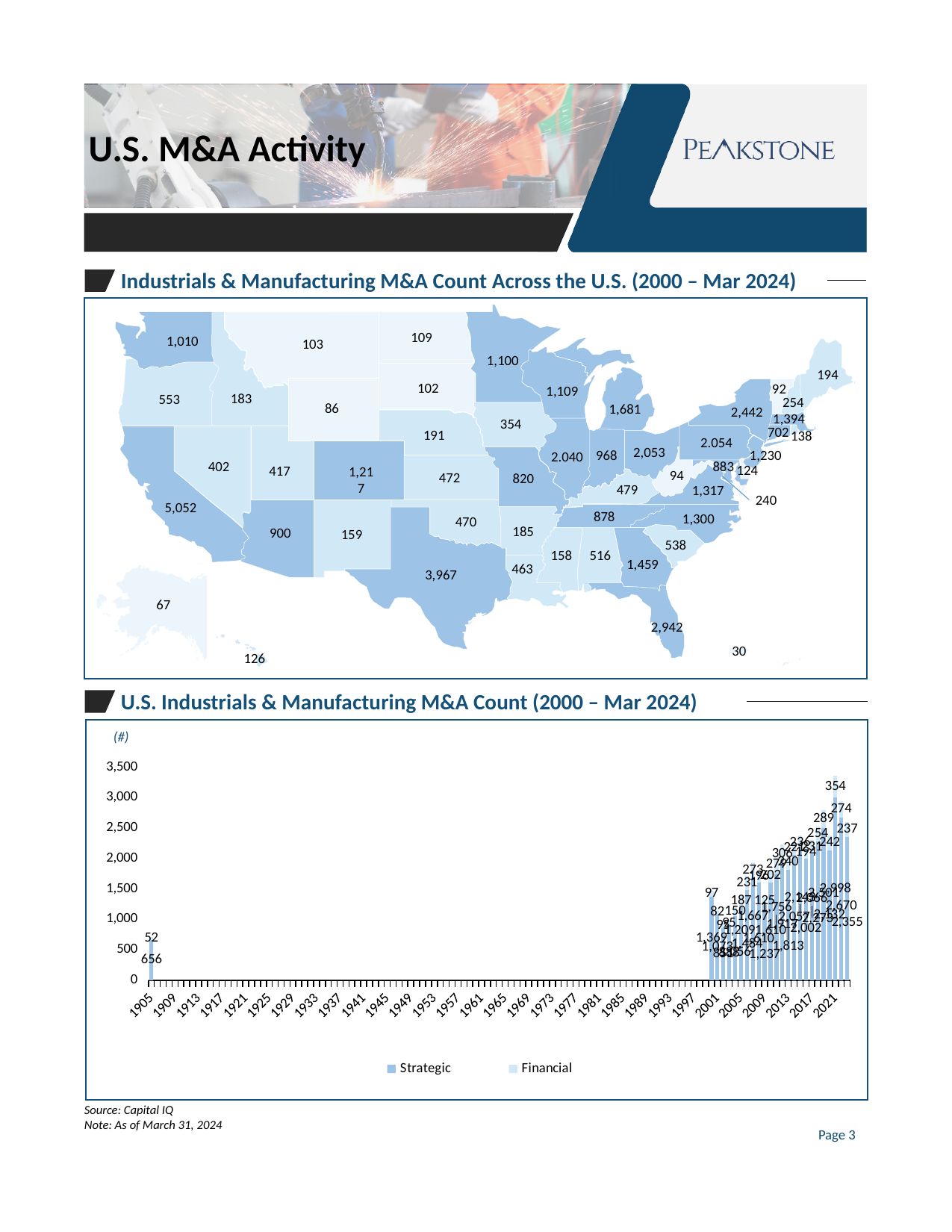
On the map chart 'Industrials & Manufacturing M&A Count Across the U.S. (2000 – Mar 2024)', what is the M&A count shown for California? 5,052 On the bar chart 'U.S. Industrials & Manufacturing M&A Count (2000 – Mar 2024)', what are the two series named in the legend? Strategic and Financial On the map chart 'Industrials & Manufacturing M&A Count Across the U.S. (2000 – Mar 2024)', which state has the highest M&A count? California On the bar chart 'U.S. Industrials & Manufacturing M&A Count (2000 – Mar 2024)', what is the Strategic value labeled for 1905? 656 On the map chart 'Industrials & Manufacturing M&A Count Across the U.S. (2000 – Mar 2024)', what is the M&A count shown for Alaska? 67 On the bar chart 'U.S. Industrials & Manufacturing M&A Count (2000 – Mar 2024)', what is the Financial value labeled for 1905? 52 On the bar chart 'U.S. Industrials & Manufacturing M&A Count (2000 – Mar 2024)', how many series does the legend list? 2 What kind of chart is 'U.S. Industrials & Manufacturing M&A Count (2000 – Mar 2024)'? Stacked bar chart On the map chart 'Industrials & Manufacturing M&A Count Across the U.S. (2000 – Mar 2024)', what is the M&A count shown for Florida? 2,942 On the map chart 'Industrials & Manufacturing M&A Count Across the U.S. (2000 – Mar 2024)', which has a higher M&A count, Texas or Florida? Texas On the map chart 'Industrials & Manufacturing M&A Count Across the U.S. (2000 – Mar 2024)', what is the M&A count shown for Texas? 3,967 On the map chart 'Industrials & Manufacturing M&A Count Across the U.S. (2000 – Mar 2024)', what is the difference between the counts for California and Texas? 1,085